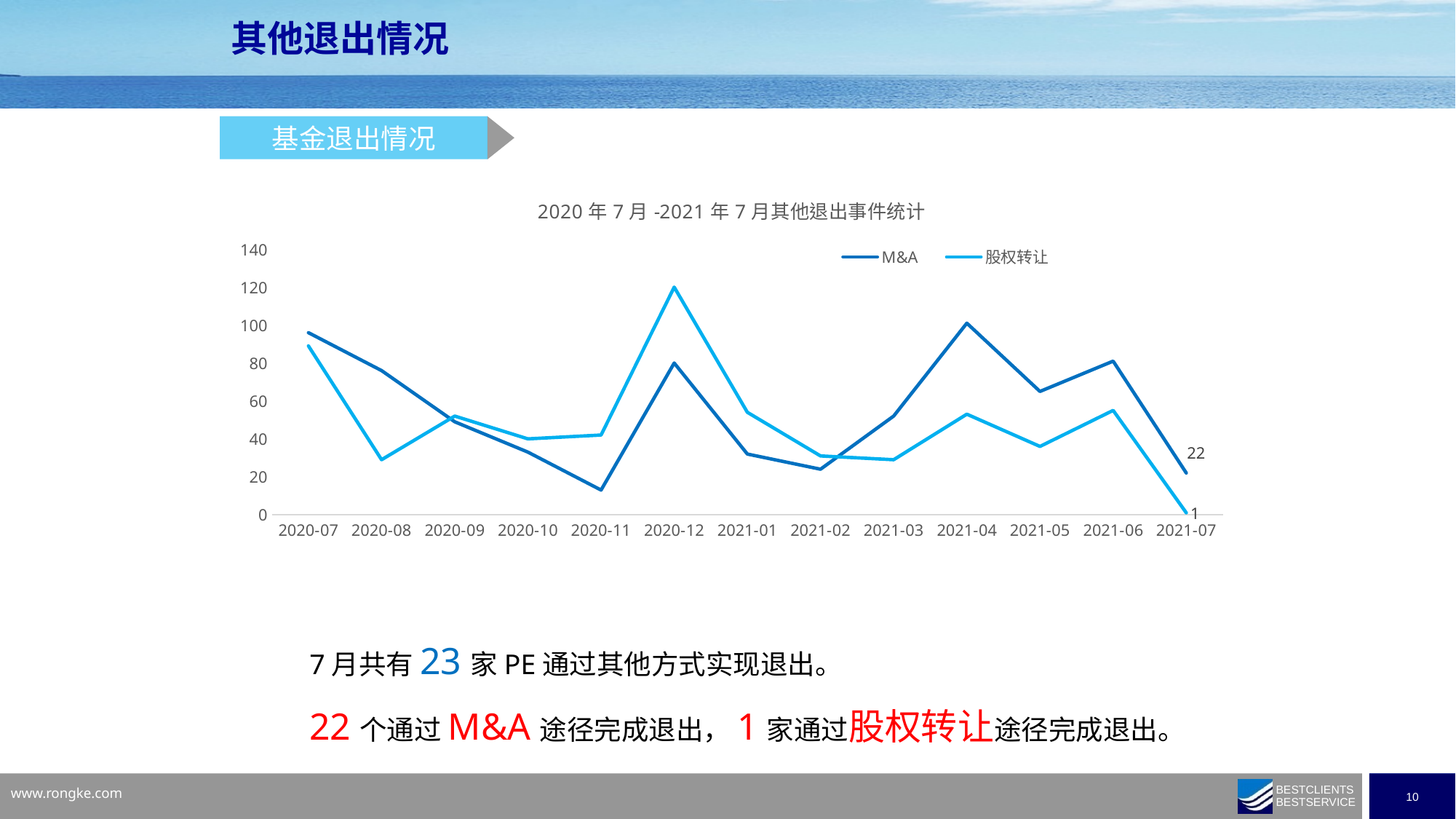
What is the value for 股权转让 in 2021-07? 1 How many months are plotted along the x axis? 13 What is the difference between the M&A value and the 股权转让 value in 2021-07? 21 How many series does the legend list? 2 What is the value for M&A in 2021-07? 22 In which month does the 股权转让 series reach its highest value? 2020-12 What is the title of the chart? 2020年7月-2021年7月其他退出事件统计 In which month does the 股权转让 series reach its lowest value? 2021-07 In 2020-12, which series has the larger value, M&A or 股权转让? 股权转让 Is the value for M&A in 2020-11 greater or less than 20? less Is the value for 股权转让 in 2020-12 greater or less than 100? greater What kind of chart is shown on the slide? Line chart